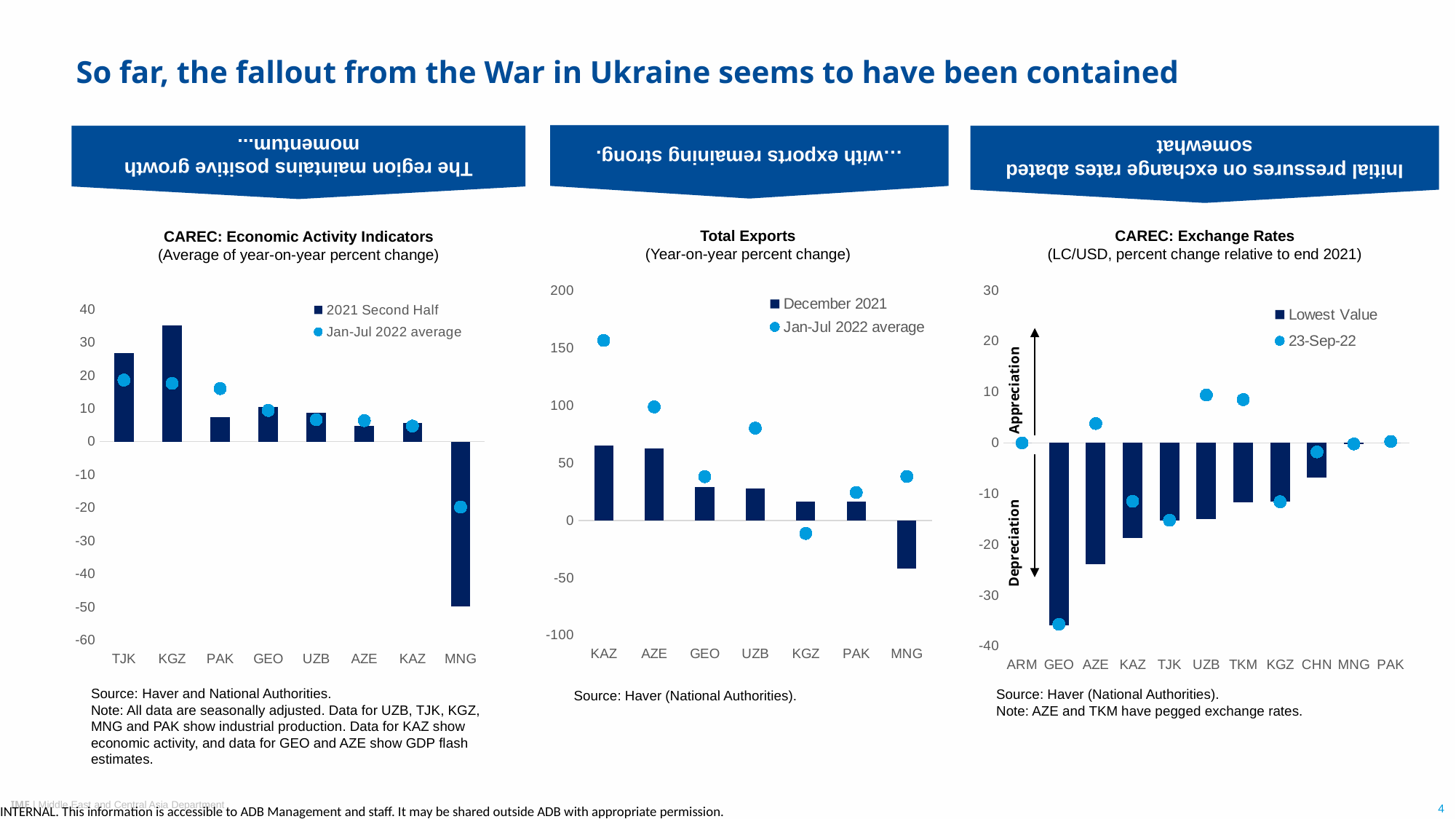
On the CAREC: Economic Activity Indicators chart, is the 2021 Second Half value for MNG greater or less than -40? less On the Total Exports chart, is the Jan-Jul 2022 average value for KAZ greater or less than 150? greater On the CAREC: Economic Activity Indicators chart, which category has the highest 2021 Second Half bar? KGZ On the Total Exports chart, how many categories are shown on the x axis? 7 On the CAREC: Exchange Rates chart, how many categories are shown on the x axis? 11 On the CAREC: Economic Activity Indicators chart, how many categories are shown on the x axis? 8 On the CAREC: Economic Activity Indicators chart, which category has the lowest 2021 Second Half bar? MNG On the Total Exports chart, which category has the highest Jan-Jul 2022 average value? KAZ On the CAREC: Exchange Rates chart, which category has the lowest Lowest Value bar? GEO On the Total Exports chart, which category has the lowest December 2021 bar? MNG On the CAREC: Economic Activity Indicators chart, how many series does the legend list? 2 On the Total Exports chart, which is larger, the Jan-Jul 2022 average for KAZ or for AZE? KAZ